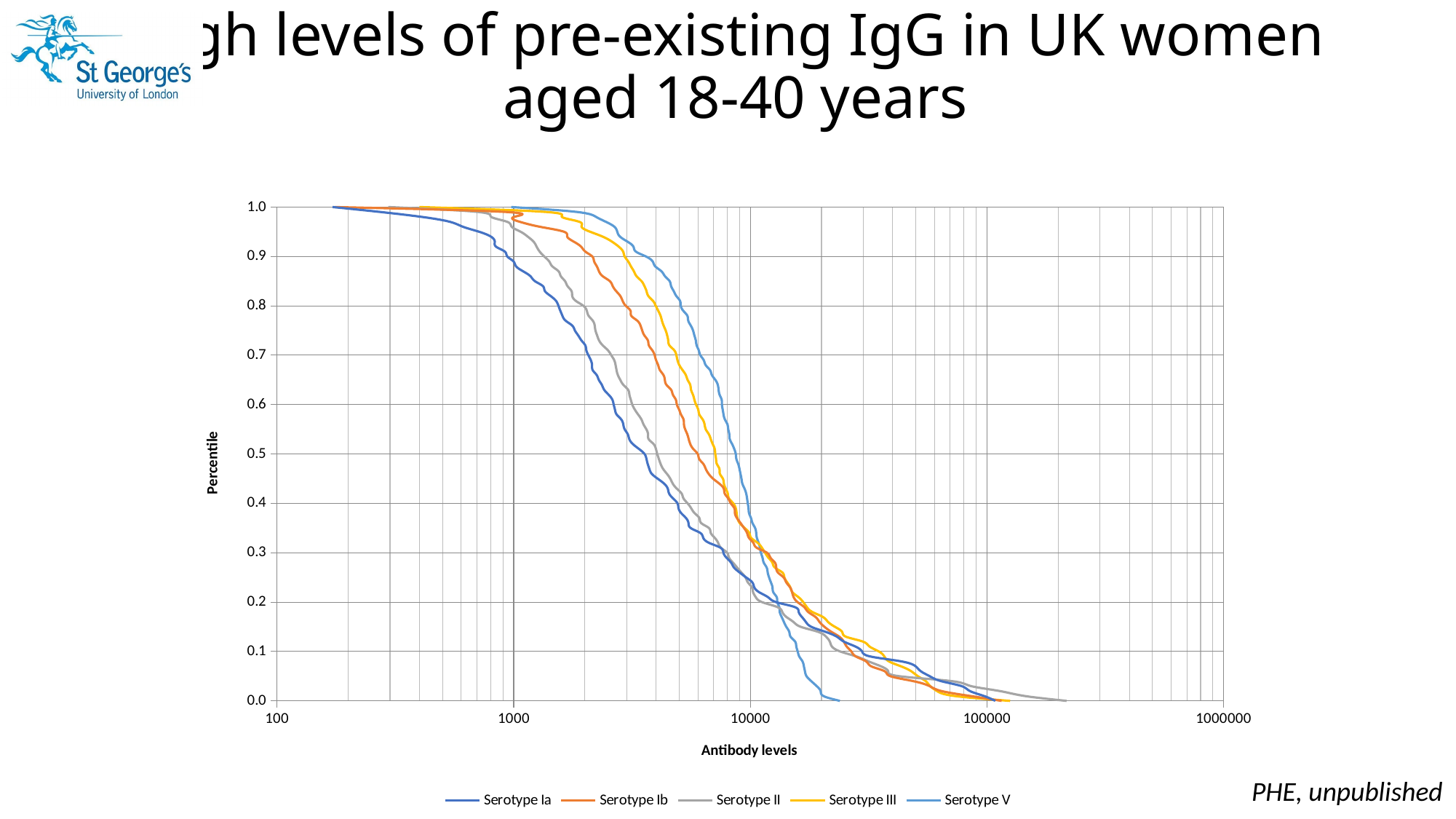
What kind of chart is shown on the slide? Line chart At a percentile of 0.5, which series has the higher antibody level, Serotype II or Serotype III? Serotype III Which series extends to the highest antibody level before reaching a percentile of 0.0? Serotype II At a percentile of 0.5, is the antibody level for Serotype Ia greater or less than 10000? less At a percentile of 0.1, is the antibody level for Serotype V greater or less than 100000? less As antibody levels increase along the x axis, do the percentile values rise or fall? Fall What is the label of the y axis? Percentile At a percentile of 0.9, is the antibody level for Serotype V greater or less than 1000? greater How many series does the legend list? 5 At a percentile of 0.8, which series has the higher antibody level, Serotype Ia or Serotype V? Serotype V What is the label of the x axis? Antibody levels Which series reaches a percentile of 0.0 at the lowest antibody level? Serotype V